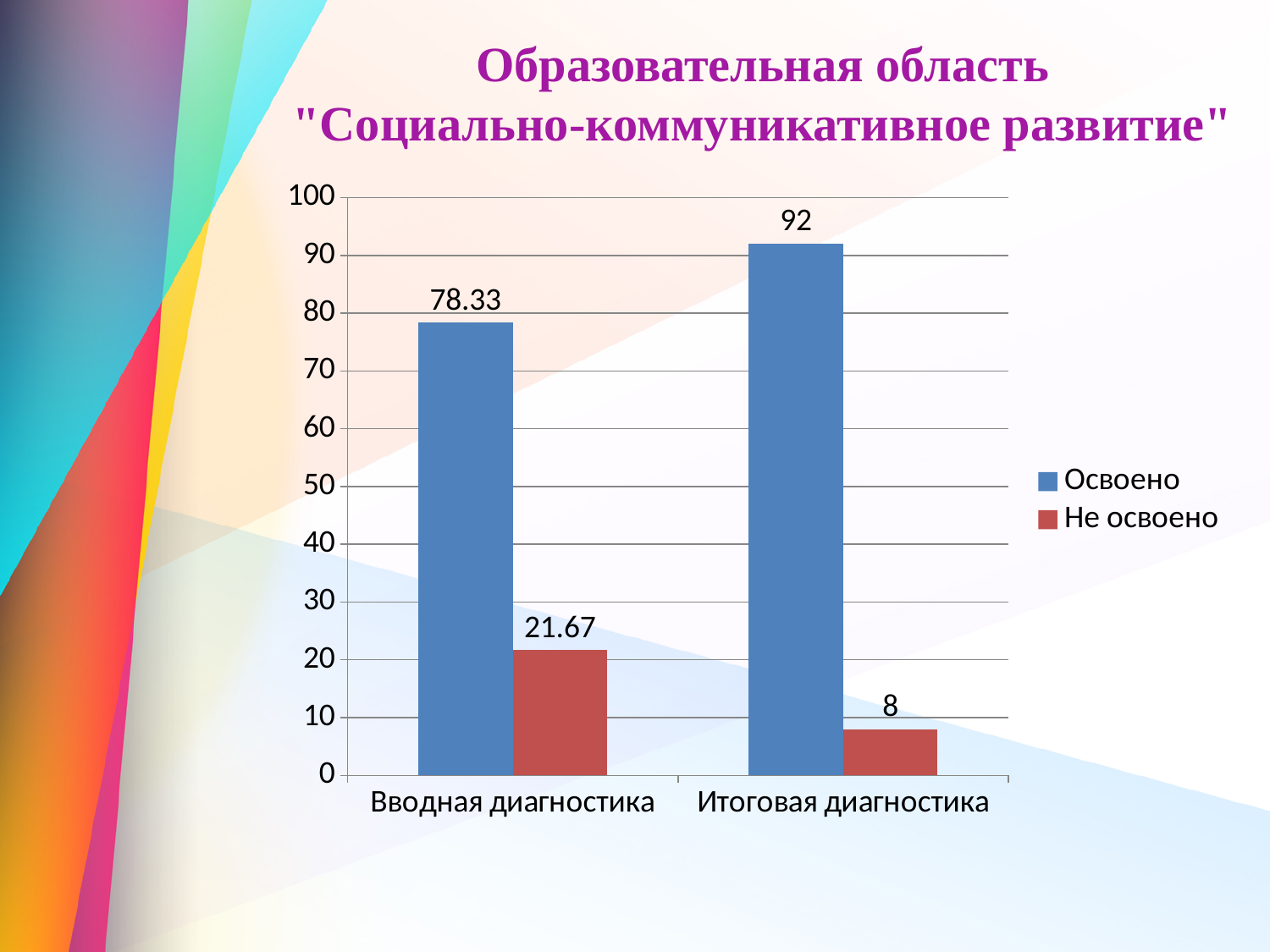
What kind of chart is shown on the slide? bar chart Which category has the lowest value for "Не освоено"? Итоговая диагностика Which category has the highest value for "Освоено"? Итоговая диагностика What is the value for "Не освоено" in "Итоговая диагностика"? 8 How many series does the legend list? 2 Is the value for "Освоено" in "Итоговая диагностика" greater or less than 90? greater What is the value for "Освоено" in "Итоговая диагностика"? 92 Which is larger: "Не освоено" in "Вводная диагностика" or "Не освоено" in "Итоговая диагностика"? Вводная диагностика What is the difference between the "Освоено" values for "Итоговая диагностика" and "Вводная диагностика"? 13.67 What is the value for "Не освоено" in "Вводная диагностика"? 21.67 What is the value for "Освоено" in "Вводная диагностика"? 78.33 How many categories are shown on the x axis? 2